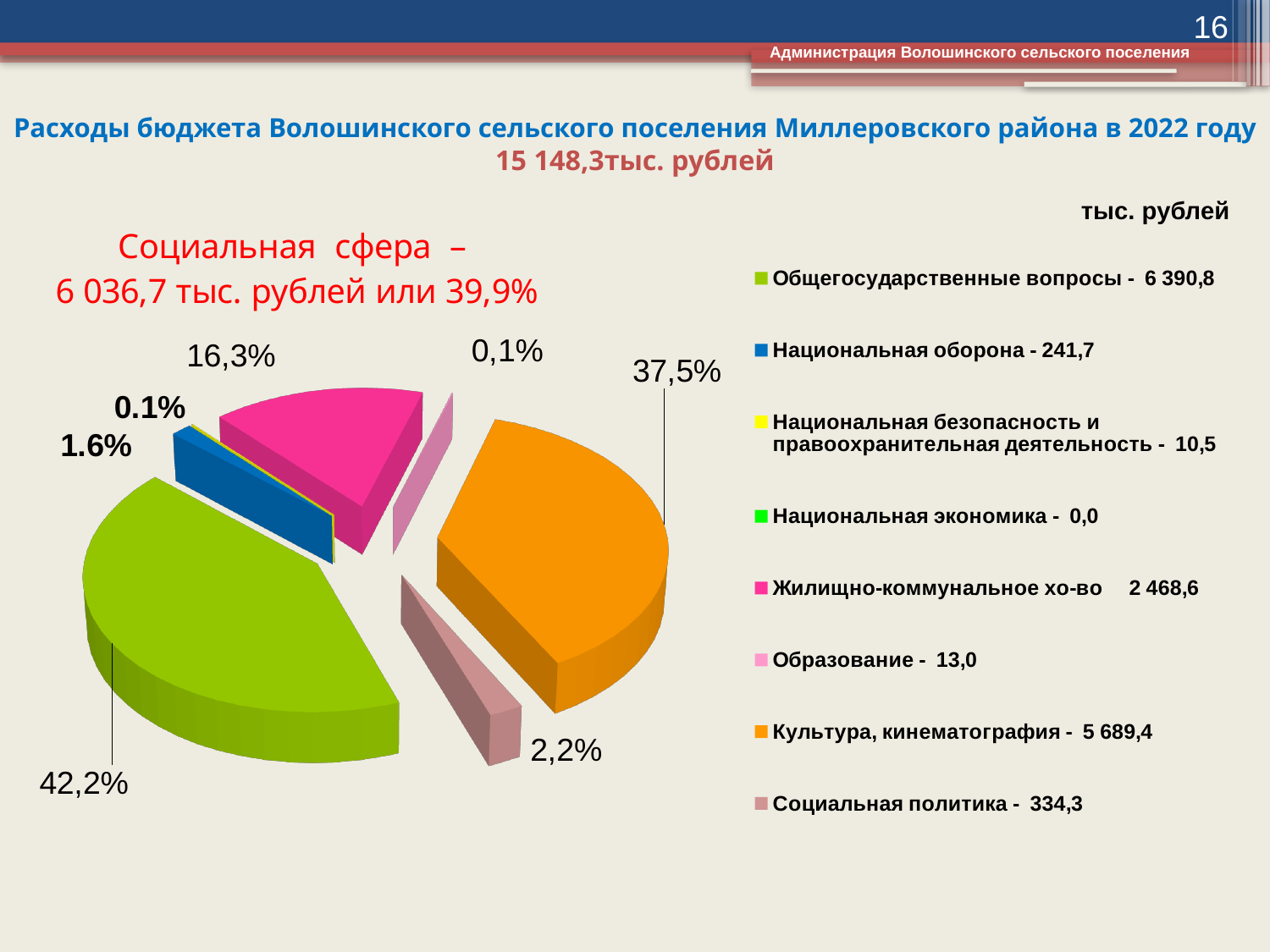
What is the difference between the values for Общегосударственные вопросы and Культура, кинематография? 701,4 How many categories does the legend of the pie chart list? 8 What value does the legend give for Жилищно-коммунальное хо-во? 2 468,6 Which category has the smallest value in the legend? Национальная экономика Which is larger: Национальная оборона or Образование? Национальная оборона What value does the legend give for Социальная политика? 334,3 What value does the legend give for Культура, кинематография? 5 689,4 What kind of chart is shown on the slide? pie chart What share of the pie is labelled for the Культура, кинематография slice? 37,5% What is the unit of measurement stated above the legend? тыс. рублей Which category has the largest value in the pie chart? Общегосударственные вопросы What value does the legend give for Общегосударственные вопросы? 6 390,8